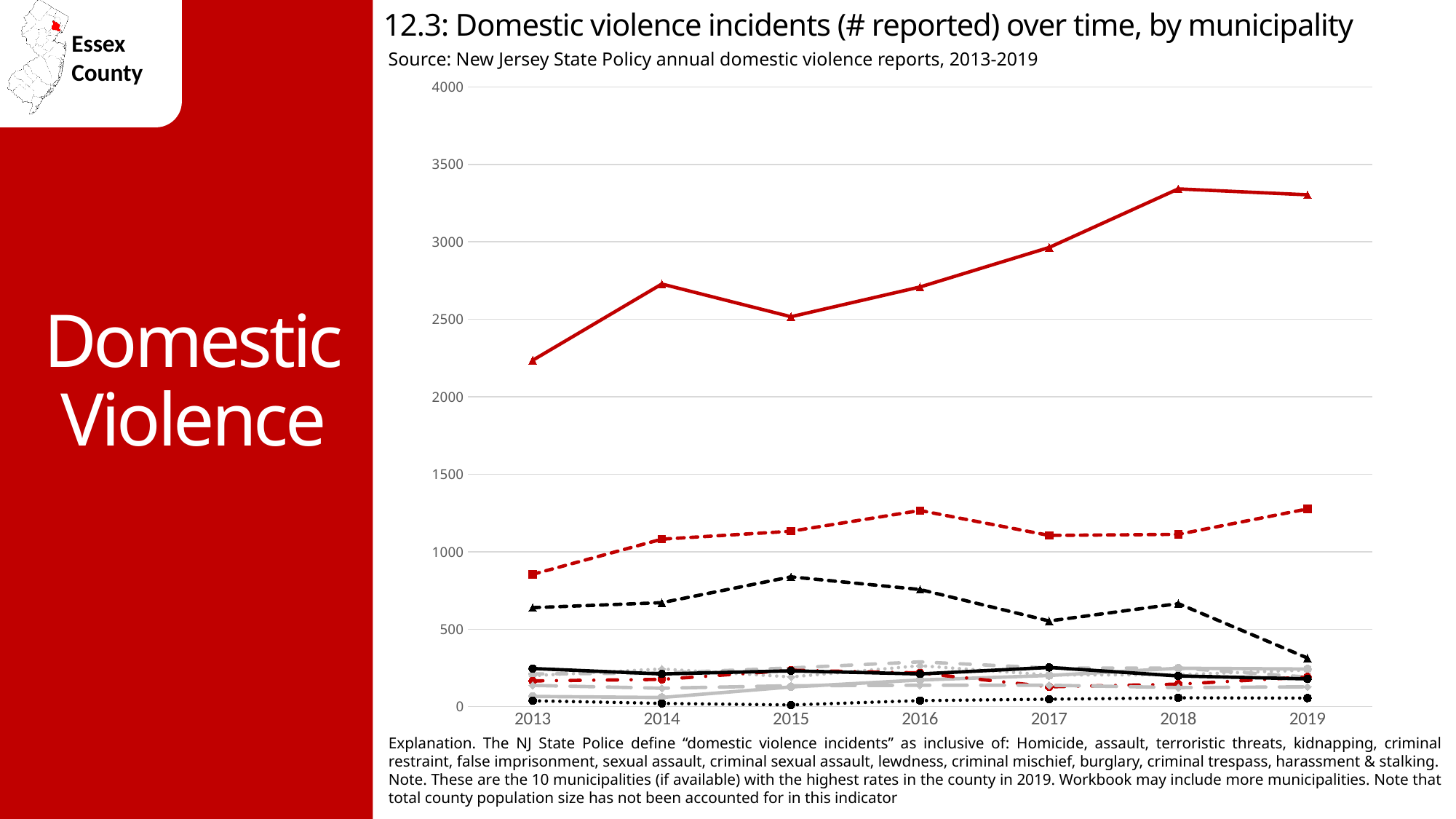
How many years are shown along the x axis of the chart? 7 Does the solid red line with triangle markers generally rise or fall from 2013 to 2019? rise Is the value of the solid red line with triangle markers in 2019 greater or less than 3000? greater Is the value of the solid red line with triangle markers in 2013 greater or less than 2500? less What source is cited for the chart data? New Jersey State Policy annual domestic violence reports, 2013-2019 In which year does the solid red line with triangle markers reach its highest value? 2018 What kind of chart is shown on the slide? line chart What is the title of the chart on the slide? 12.3: Domestic violence incidents (# reported) over time, by municipality In which year does the dashed black line with triangle markers reach its highest value? 2015 Is the value of the dashed red line with square markers in 2016 greater or less than 1000? greater In which year is the solid red line with triangle markers at its lowest value? 2013